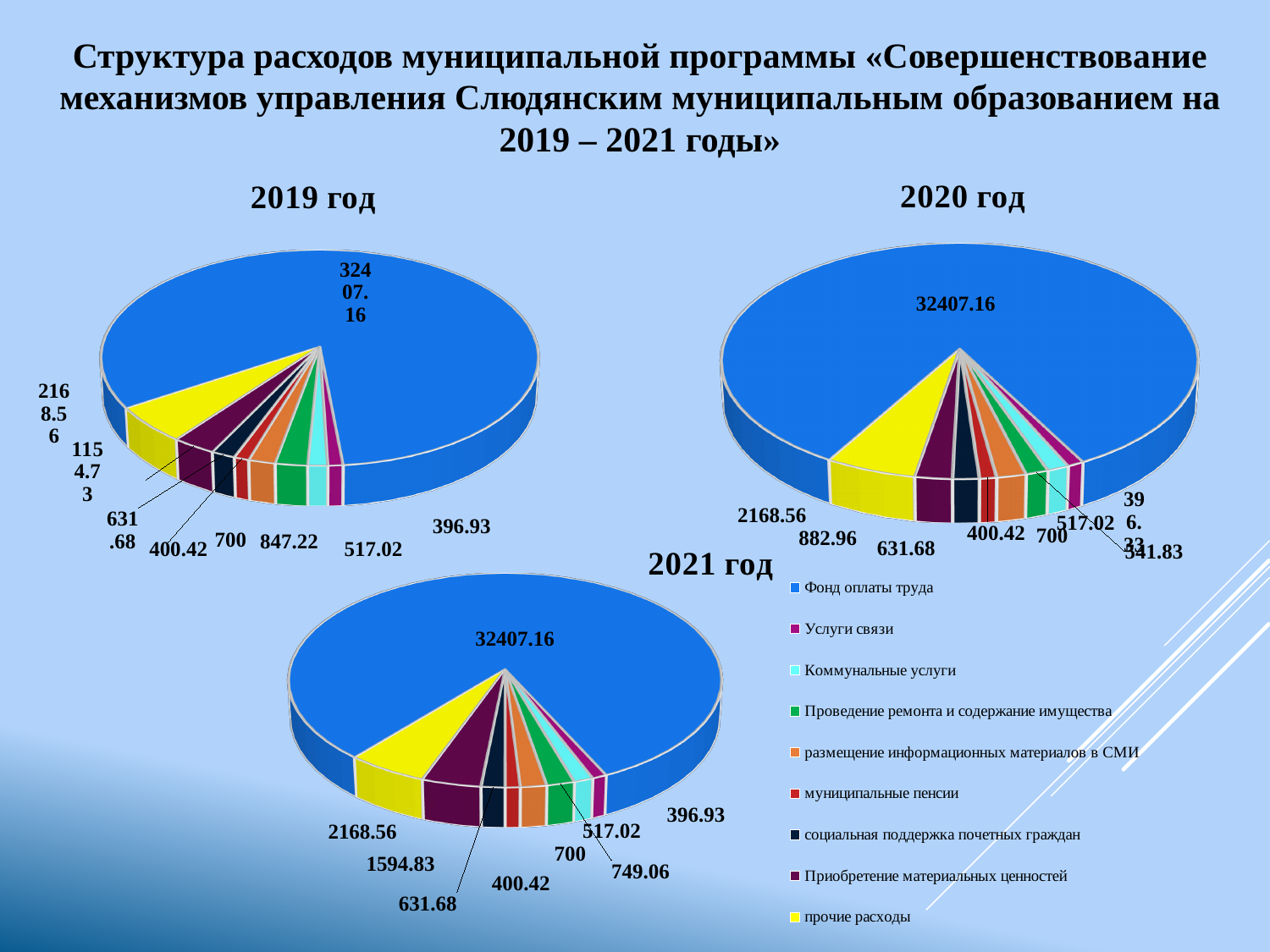
In the 2020 год chart, which category has the largest slice? Фонд оплаты труда In the 2021 год chart, what is the value for Приобретение материальных ценностей? 1594.83 In the 2021 год chart, what is the value for прочие расходы? 2168.56 What colour represents Фонд оплаты труда in the legend? Blue In the 2019 год chart, what is the value for Фонд оплаты труда? 32407.16 In the 2020 год chart, what is the value for Приобретение материальных ценностей? 882.96 Which is larger: Приобретение материальных ценностей in the 2021 год chart or in the 2020 год chart? 2021 год How many categories does the legend list? 9 In the 2020 год chart, what is the value for прочие расходы? 2168.56 In the 2021 год chart, what is the difference between прочие расходы and Приобретение материальных ценностей? 573.73 How many pie charts are on the slide? 3 What kind of charts are shown on the slide? Pie charts